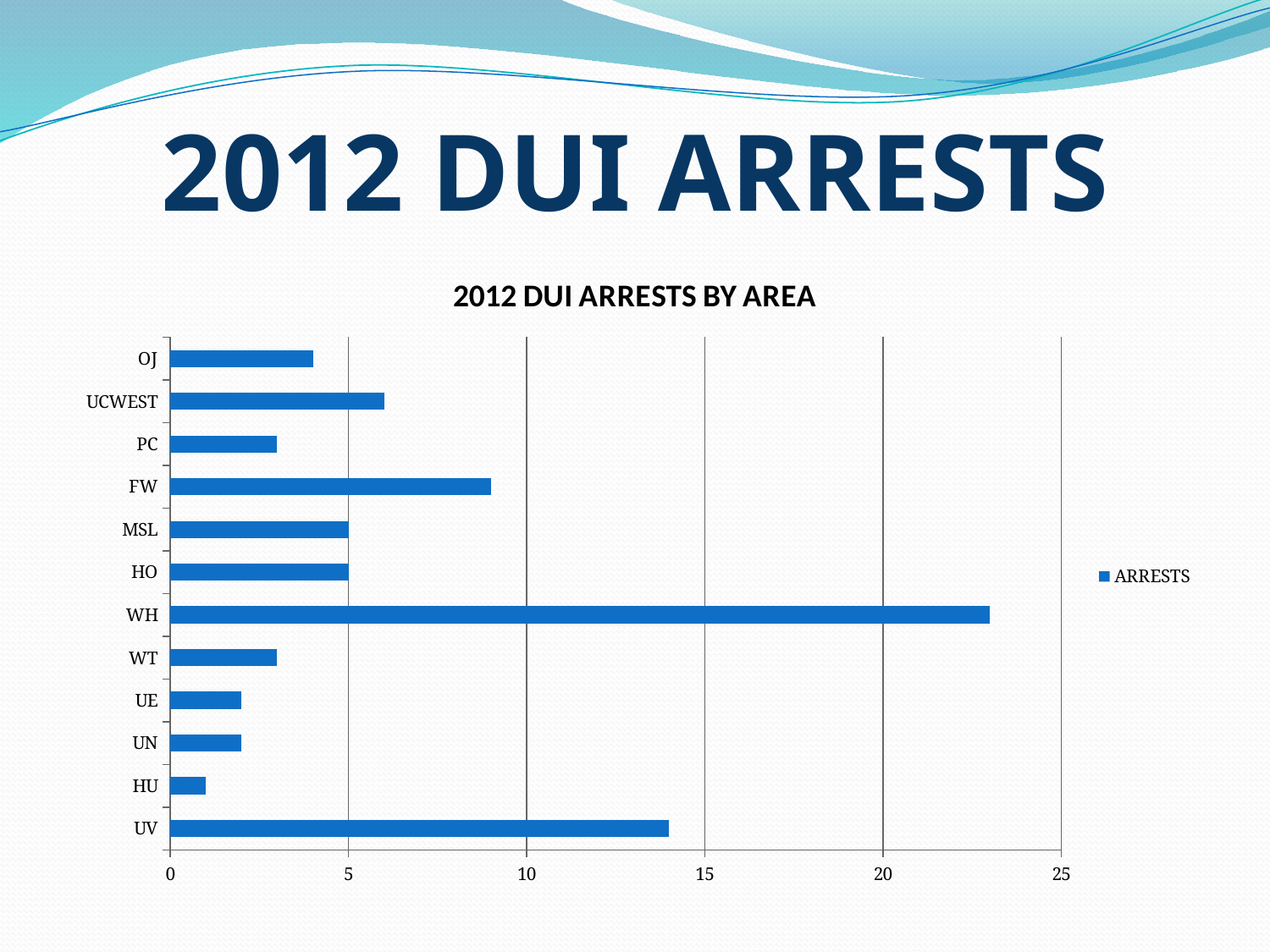
How many series does the legend list? 1 Is the value for WH greater or less than 20? greater What kind of chart is shown on the slide? bar chart Which area has the lowest number of arrests? HU Which area has the highest number of arrests? WH How many areas (categories) are shown in the chart? 12 Is the value for FW greater or less than 10? less Which has more arrests, UV or FW? UV Which has more arrests, UCWEST or PC? UCWEST Is the value for OJ greater or less than 5? less What is the title of the chart? 2012 DUI ARRESTS BY AREA